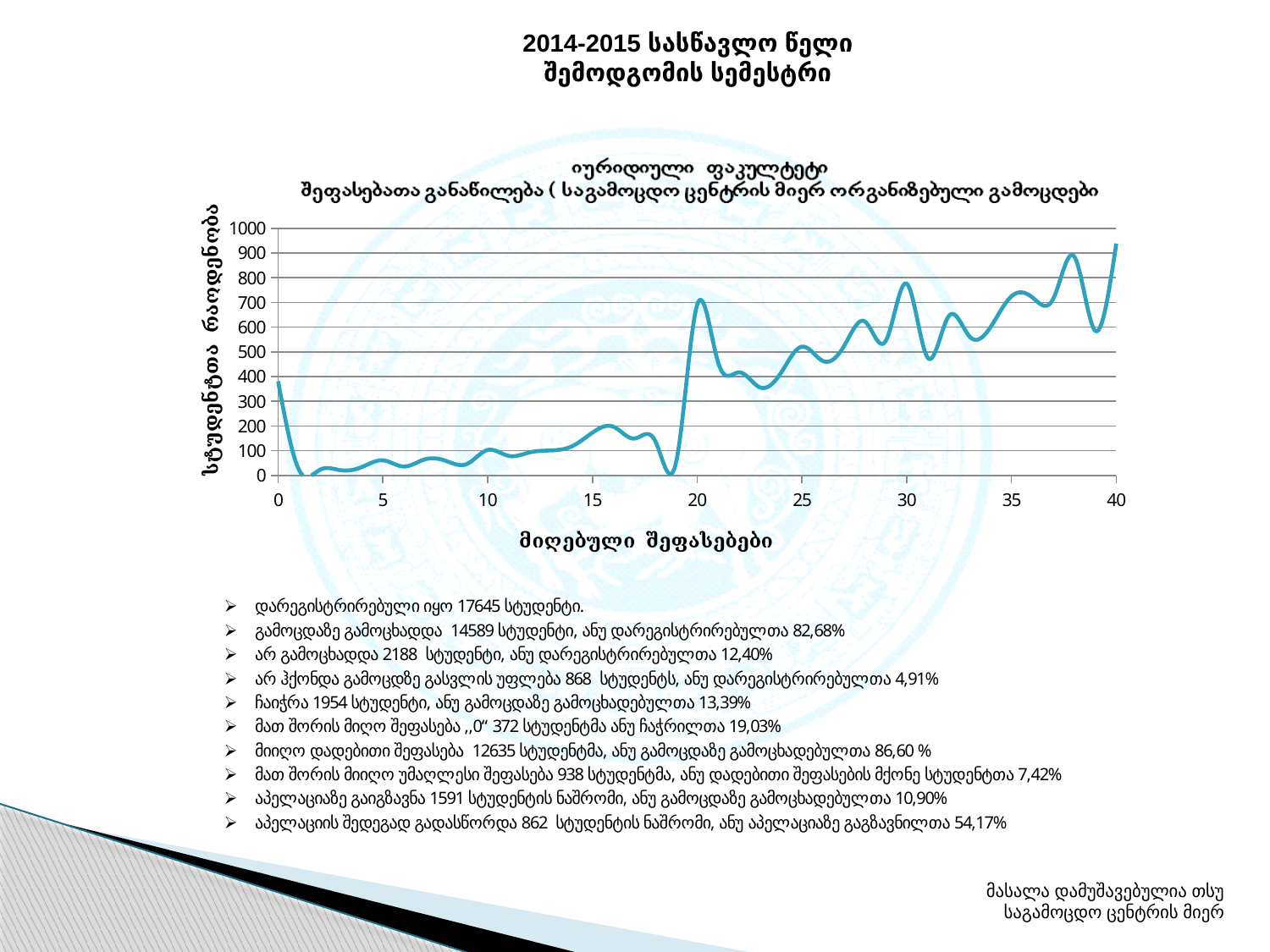
What is the highest tick value shown on the y axis? 1000 What is the label of the x axis? მიღებული შეფასებები Does the line generally rise or fall between x = 20 and x = 40? rise What kind of chart is shown on the slide? line chart Is the value at x = 5 greater or less than 200? less Is the value at x = 35 greater or less than 500? greater Does the line rise or fall between x = 0 and x = 2? fall Is the value at x = 20 greater or less than 600? greater